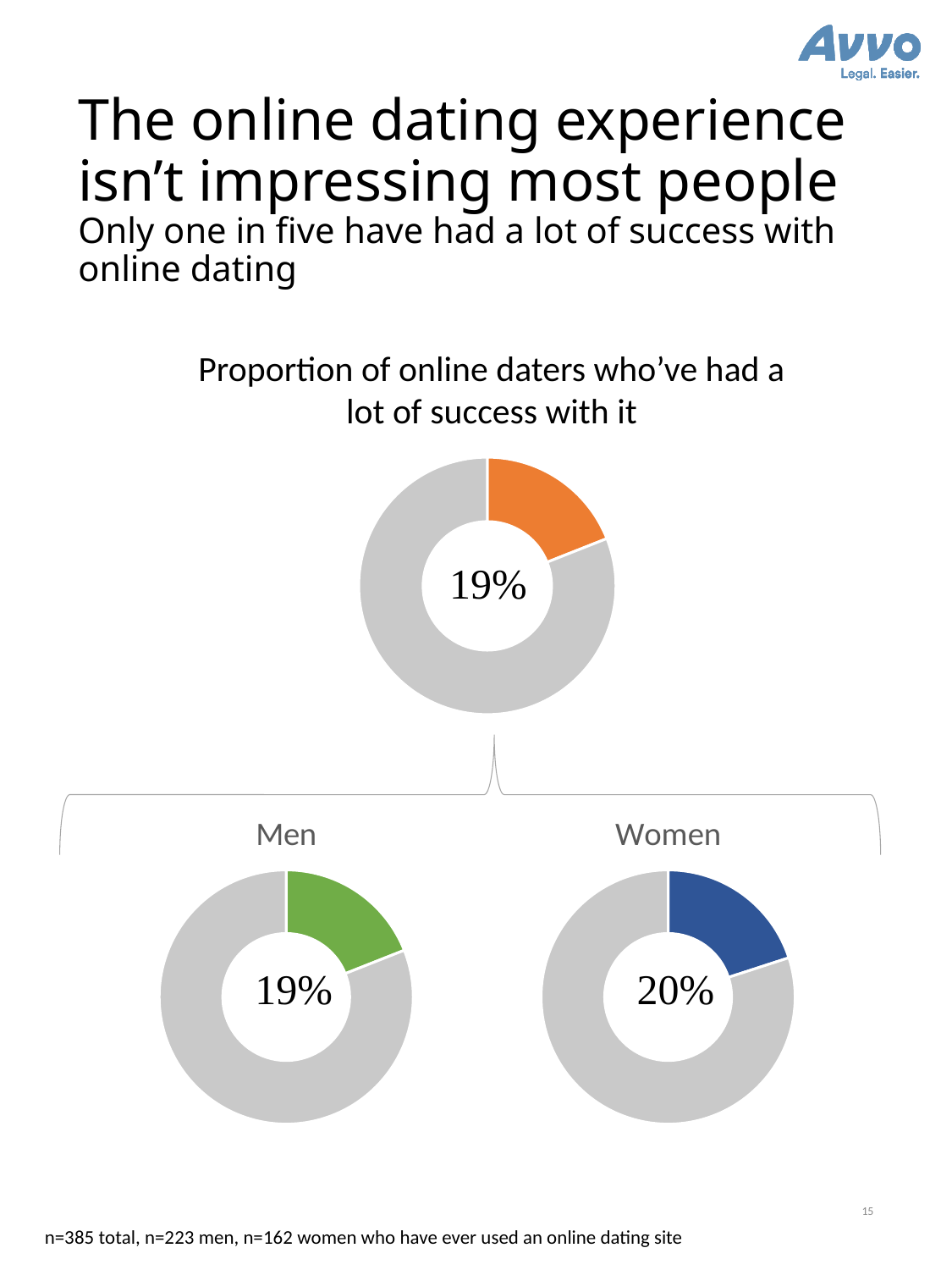
What colour is the highlighted slice in the "Men" chart? Green How many donut charts are shown on the slide? 3 In the bottom-left chart labelled "Men", what percentage is shown? 19% What is the difference in percentage points between the "Women" chart value and the "Men" chart value? 1 percentage point In the "Women" chart, what share of the donut does the blue slice represent? 20% Is the value shown in the "Women" chart greater or less than 50%? less In the top chart titled "Proportion of online daters who've had a lot of success with it", what percentage is shown in the centre of the donut? 19% What is the title of the top chart on the slide? Proportion of online daters who've had a lot of success with it What type of chart is used for the "Proportion of online daters who've had a lot of success with it" visual? Donut (pie) chart Comparing the "Men" and "Women" charts, which group has the higher proportion who've had a lot of success with online dating? Women In the top chart, what share of the donut does the orange slice represent? 19% In the bottom-right chart labelled "Women", what percentage is shown? 20%